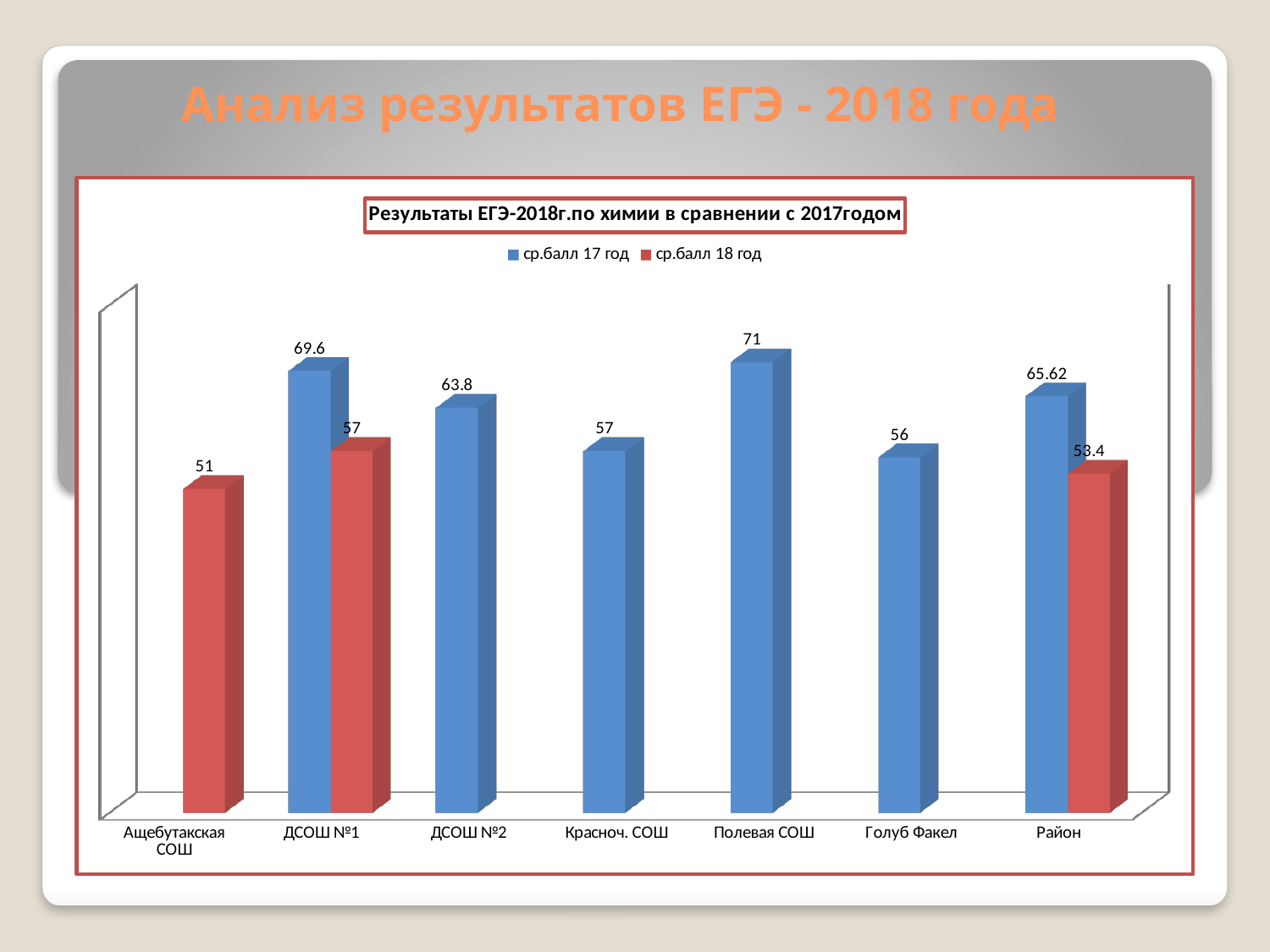
Which category has the lowest value for ср.балл 17 год? Голуб Факел How many series does the legend list? 2 What is the value of ср.балл 18 год for ДСОШ №1? 57 Which is larger for Район: ср.балл 17 год or ср.балл 18 год? ср.балл 17 год What is the difference between ср.балл 17 год and ср.балл 18 год for ДСОШ №1? 12.6 What is the value of ср.балл 18 год for Ащебутакская СОШ? 51 Which category has the highest value for ср.балл 17 год? Полевая СОШ What is the value of ср.балл 17 год for Район? 65.62 What is the value of ср.балл 17 год for Полевая СОШ? 71 How many categories are shown on the x axis? 7 What is the title of the chart? Результаты ЕГЭ-2018г.по химии в сравнении с 2017годом What kind of chart is shown on the slide? Bar chart